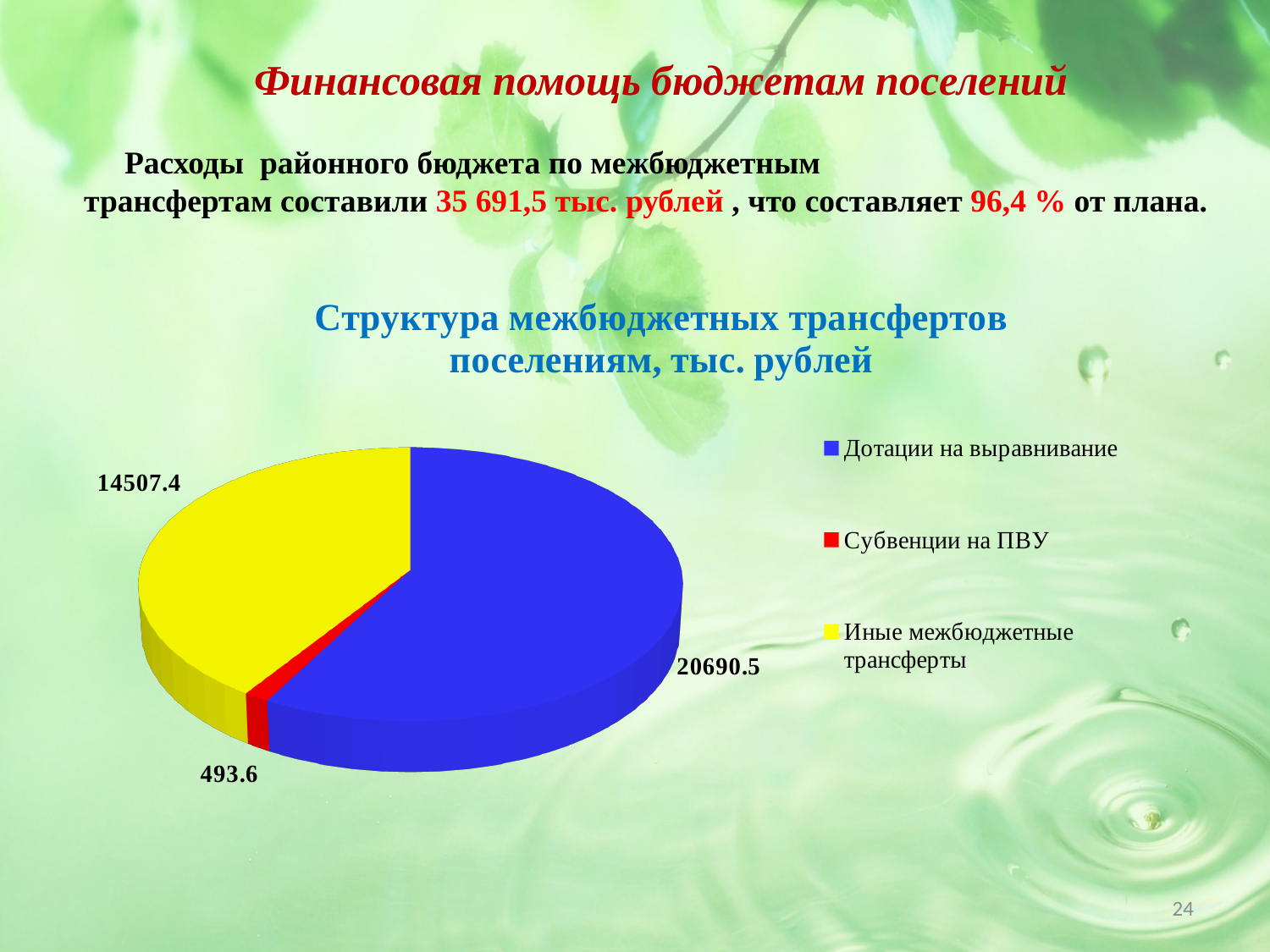
What is the difference between the values for Дотации на выравнивание and Иные межбюджетные трансферты? 6183.1 Which is larger: the value for Иные межбюджетные трансферты or the value for Субвенции на ПВУ? Иные межбюджетные трансферты What kind of chart is shown on the slide? pie chart What is the value for Дотации на выравнивание in the pie chart? 20690.5 What is the value for Субвенции на ПВУ in the pie chart? 493.6 How many slices does the pie chart have? 3 What is the total of all slices in the pie chart? 35691.5 What is the title of the pie chart? Структура межбюджетных трансфертов поселениям, тыс. рублей Which category has the smallest slice in the pie chart? Субвенции на ПВУ What share of the pie, to the nearest whole percent, does Дотации на выравнивание represent? 58% What is the value for Иные межбюджетные трансферты in the pie chart? 14507.4 Which category has the largest slice in the pie chart? Дотации на выравнивание